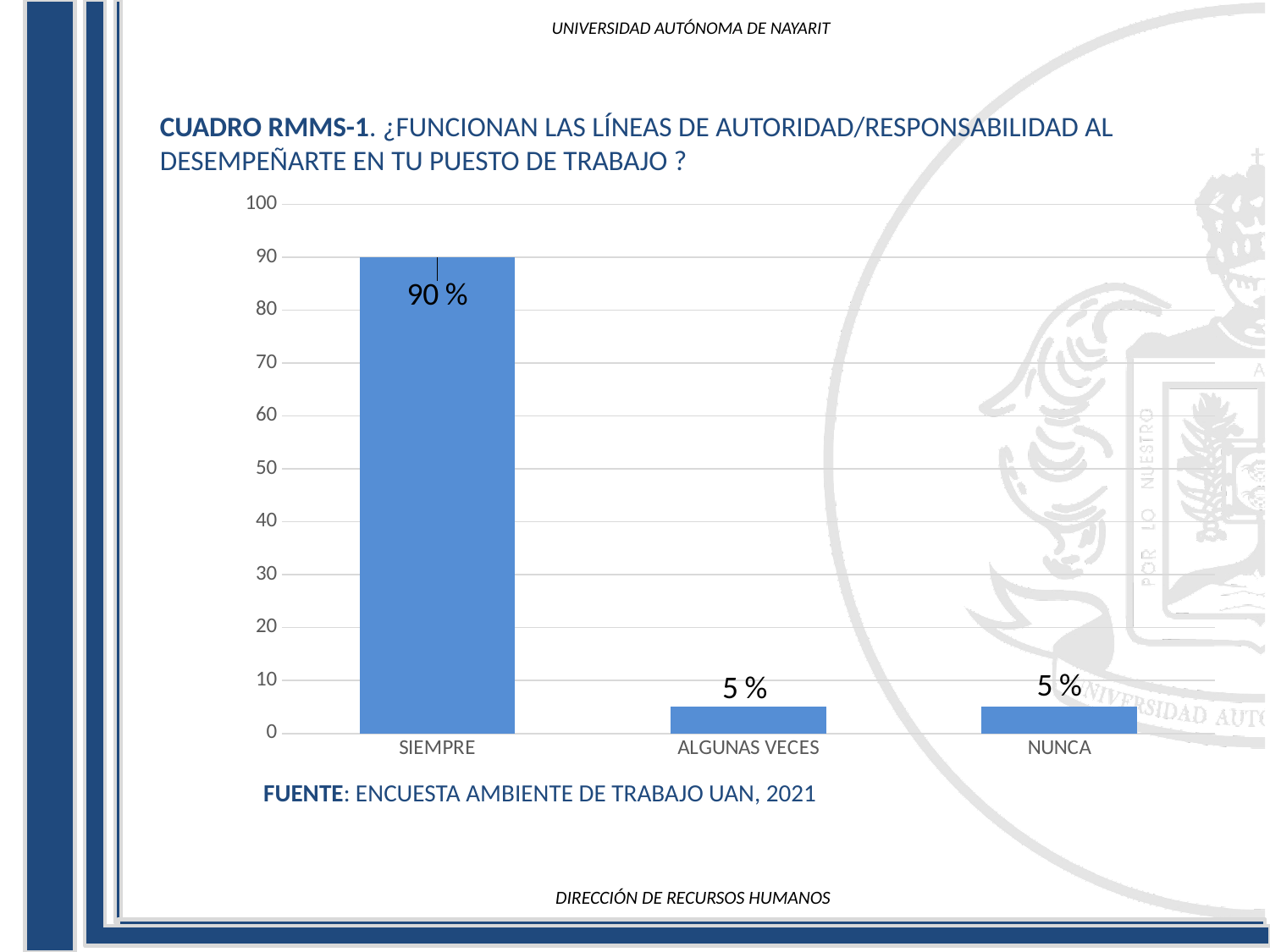
Which is larger, the value for SIEMPRE or the value for ALGUNAS VECES? SIEMPRE What is the highest value shown on the y axis? 100 Is the value for NUNCA greater or less than 10? less Is the value for SIEMPRE greater or less than 50? greater What kind of chart is shown on the slide? bar chart What is the value for NUNCA? 5 % Which category has the highest value? SIEMPRE How many categories are shown on the x axis? 3 What is the difference between the values for SIEMPRE and NUNCA? 85 % What is the source cited below the chart? ENCUESTA AMBIENTE DE TRABAJO UAN, 2021 What is the value for ALGUNAS VECES? 5 % What is the value for SIEMPRE? 90 %